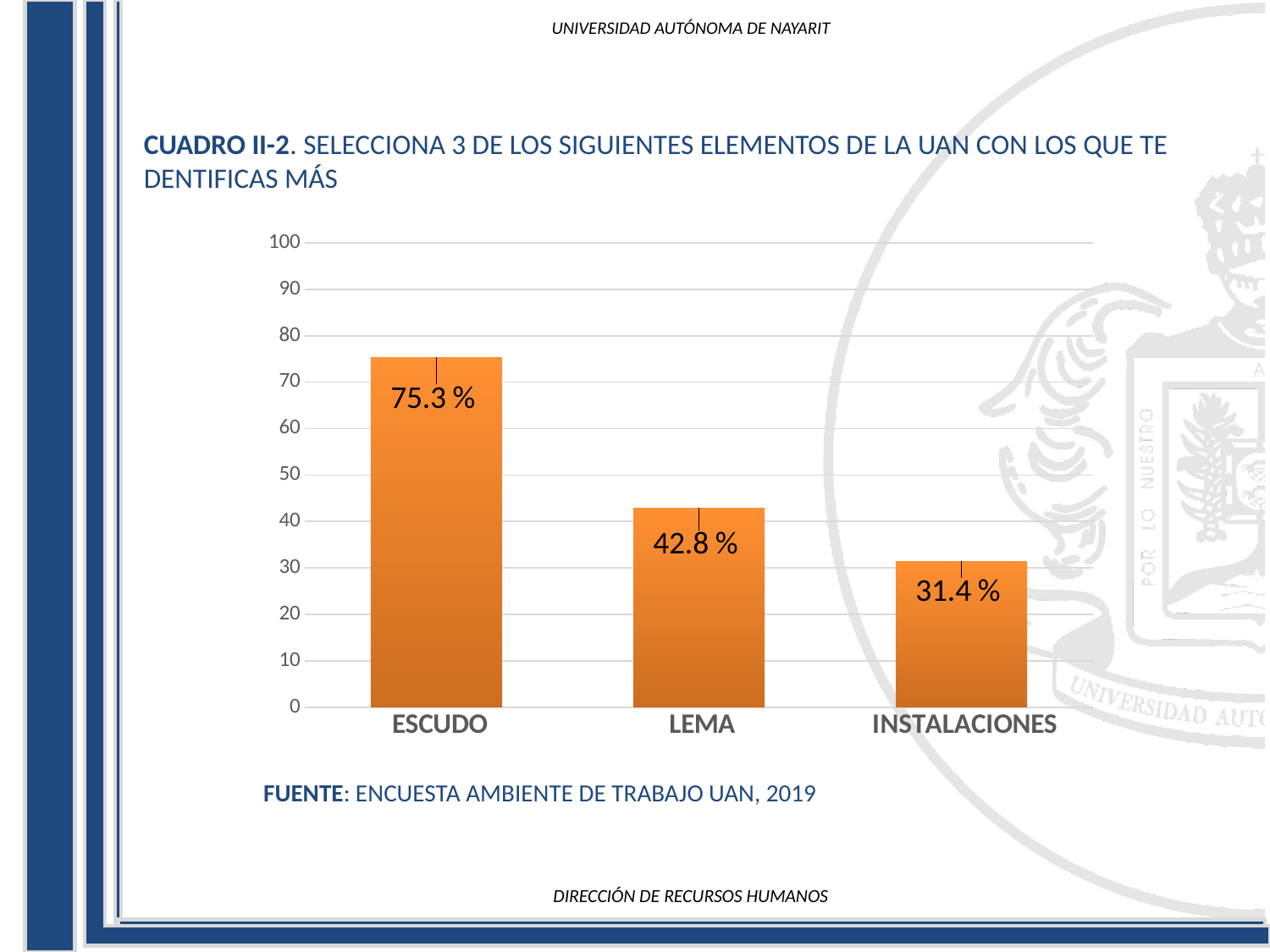
How many categories are shown in the chart? 3 What is the difference between the values for ESCUDO and LEMA? 32.5 % Do the values rise or fall from left to right across the categories? fall What is the difference between the values for LEMA and INSTALACIONES? 11.4 % Which category has the highest value? ESCUDO What is the value for INSTALACIONES? 31.4 % Is the value for ESCUDO greater or less than 70? greater What is the value for ESCUDO? 75.3 % Which is larger, the value for LEMA or the value for INSTALACIONES? LEMA What kind of chart is shown on the slide? bar chart What is the value for LEMA? 42.8 % Which category has the lowest value? INSTALACIONES